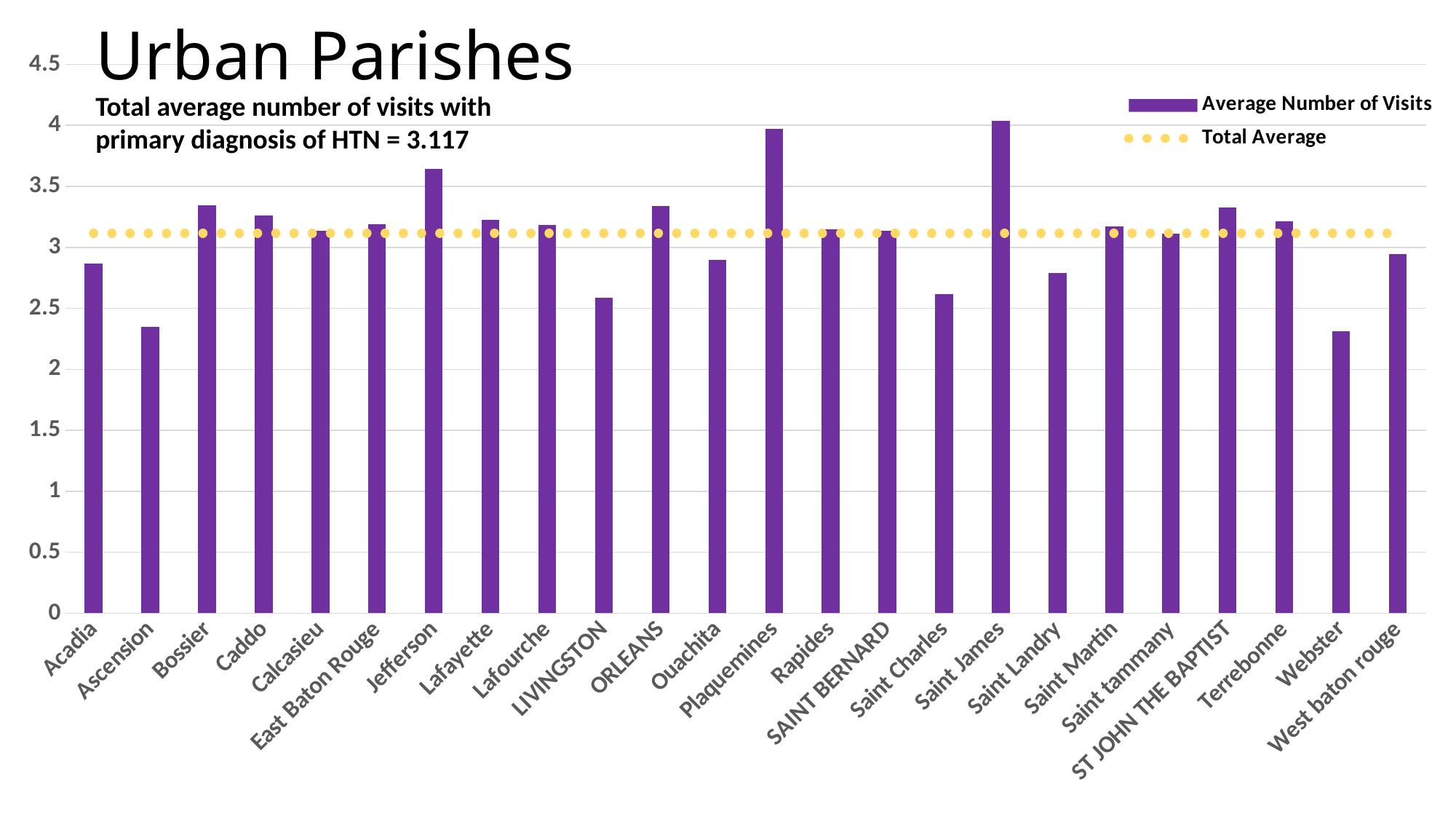
How many series does the chart legend list? 2 What does the yellow dotted line in the chart represent? Total Average How many parishes are shown on the x axis of the chart? 24 Is the value for Jefferson greater or less than 3.5? greater What type of chart is shown on the slide? bar chart Is the value for Acadia greater or less than 3? less Is the value for Ascension greater or less than 2.5? less Which has a higher average number of visits, Jefferson or Lafayette? Jefferson Which has a higher average number of visits, LIVINGSTON or ORLEANS? ORLEANS What is the total average number of visits with primary diagnosis of HTN shown on the slide? 3.117 Which parish has the highest average number of visits? Saint James